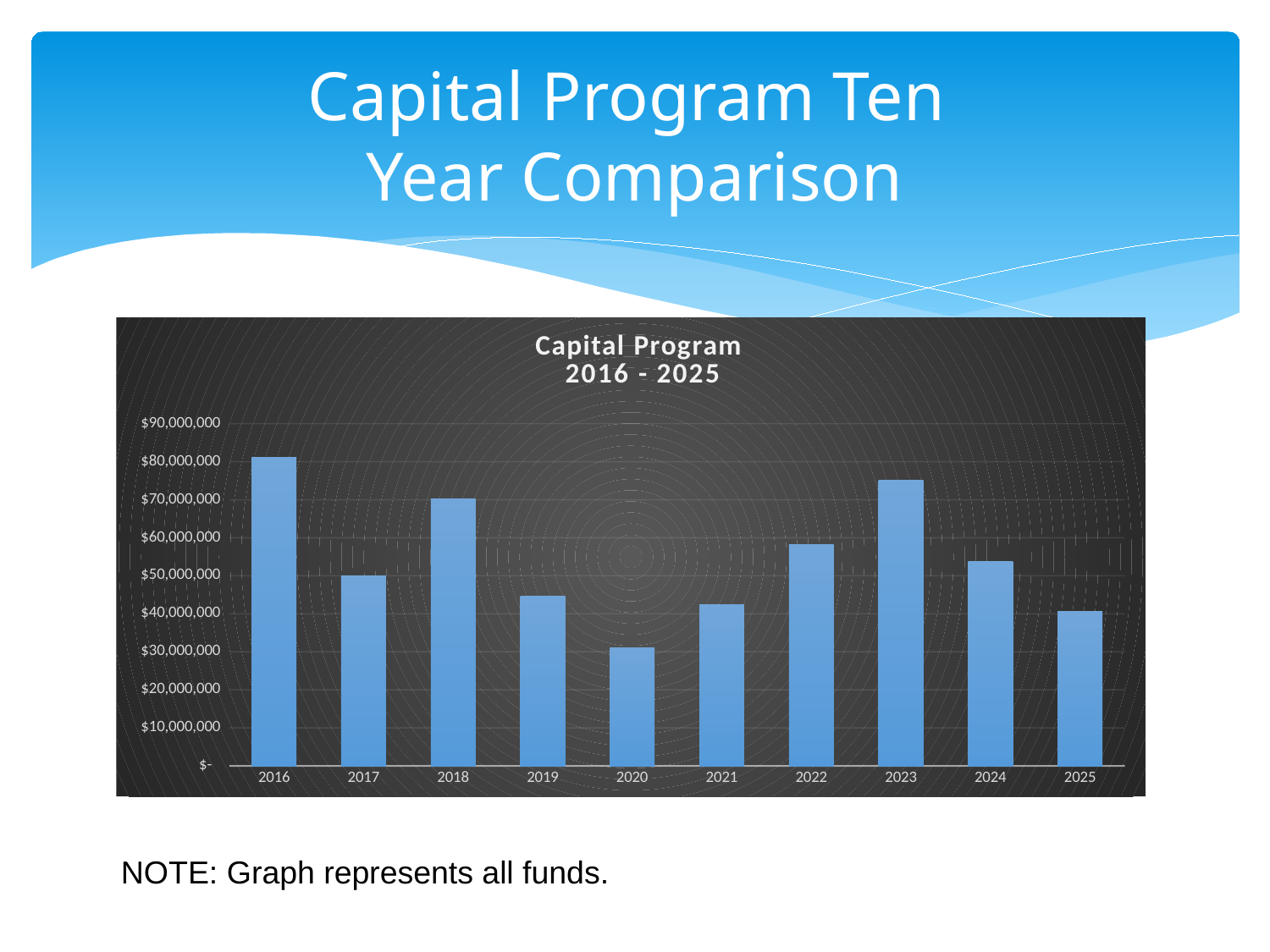
Is the value for 2022 greater or less than $50,000,000? greater Is the value for 2016 greater or less than $70,000,000? greater Which year has the highest capital program value? 2016 What is the title of the chart? Capital Program 2016 - 2025 Do the values rise or fall from 2016 to 2020? fall What kind of chart is shown on the slide? bar chart Is the value for 2019 greater or less than $50,000,000? less How many years are plotted on the chart? 10 Which year has the lowest capital program value? 2020 Which is larger, the value for 2018 or the value for 2019? 2018